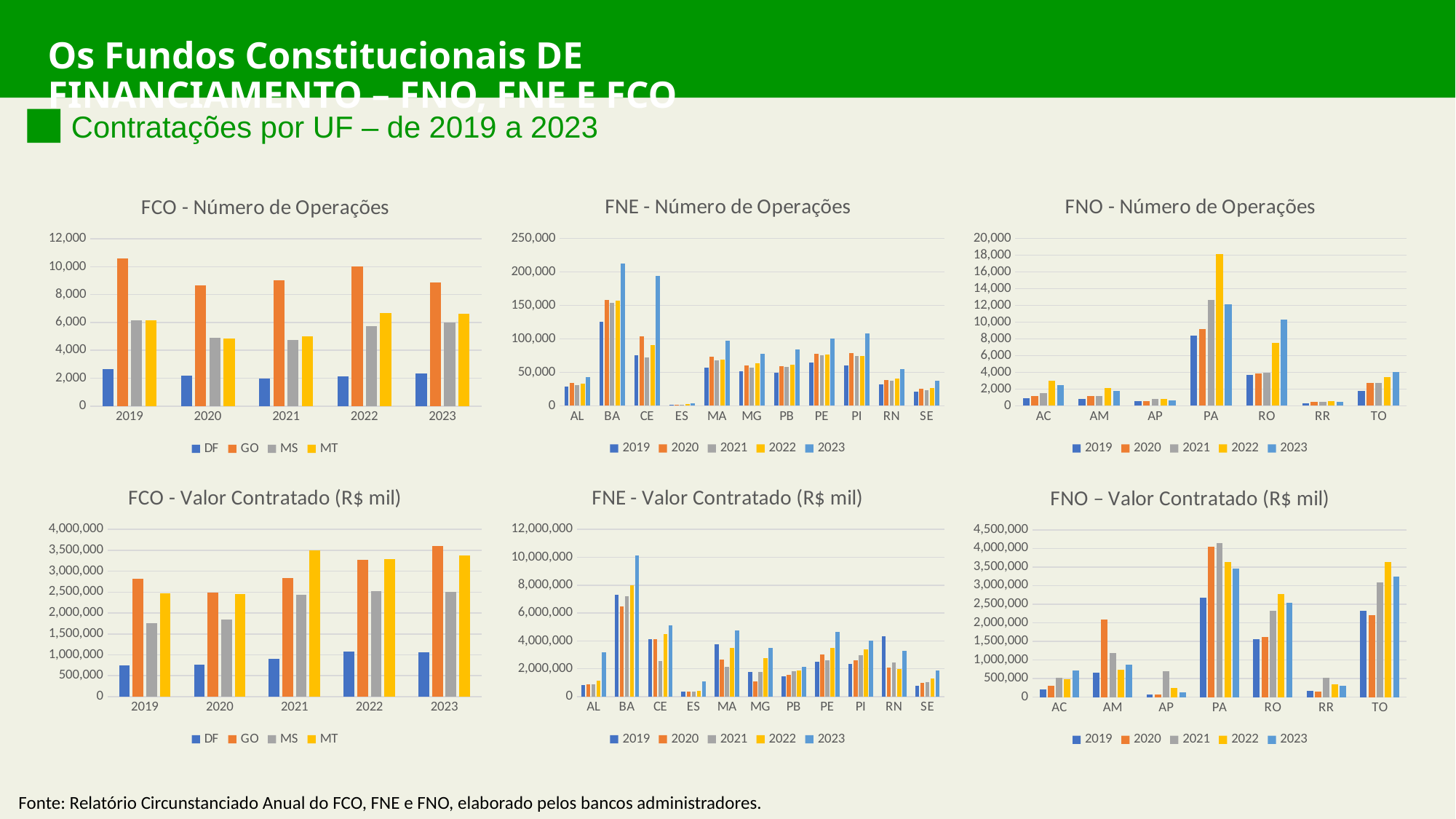
In the 'FCO - Valor Contratado (R$ mil)' chart, is the value for DF in 2019 greater or less than 1,000,000? less In the 'FNE - Número de Operações' chart, which state has the lowest number of operations across all years? ES How many series does the legend of the 'FCO - Número de Operações' chart list? 4 In the 'FNO - Número de Operações' chart, which is larger in 2022: PA or RO? PA In the 'FCO - Número de Operações' chart, which state has the highest number of operations in 2019? GO In the 'FNE - Número de Operações' chart, is the value for BA in 2023 greater or less than 200,000? greater In the 'FNE - Valor Contratado (R$ mil)' chart, which state has the highest contracted value in 2023? BA How many states (categories) are shown on the x axis of the 'FNE - Número de Operações' chart? 11 How many states (categories) are shown on the x axis of the 'FNO - Número de Operações' chart? 7 In the 'FNO - Número de Operações' chart, is the value for PA in 2022 greater or less than 16,000? greater What kind of chart is the 'FCO - Número de Operações' chart? bar chart